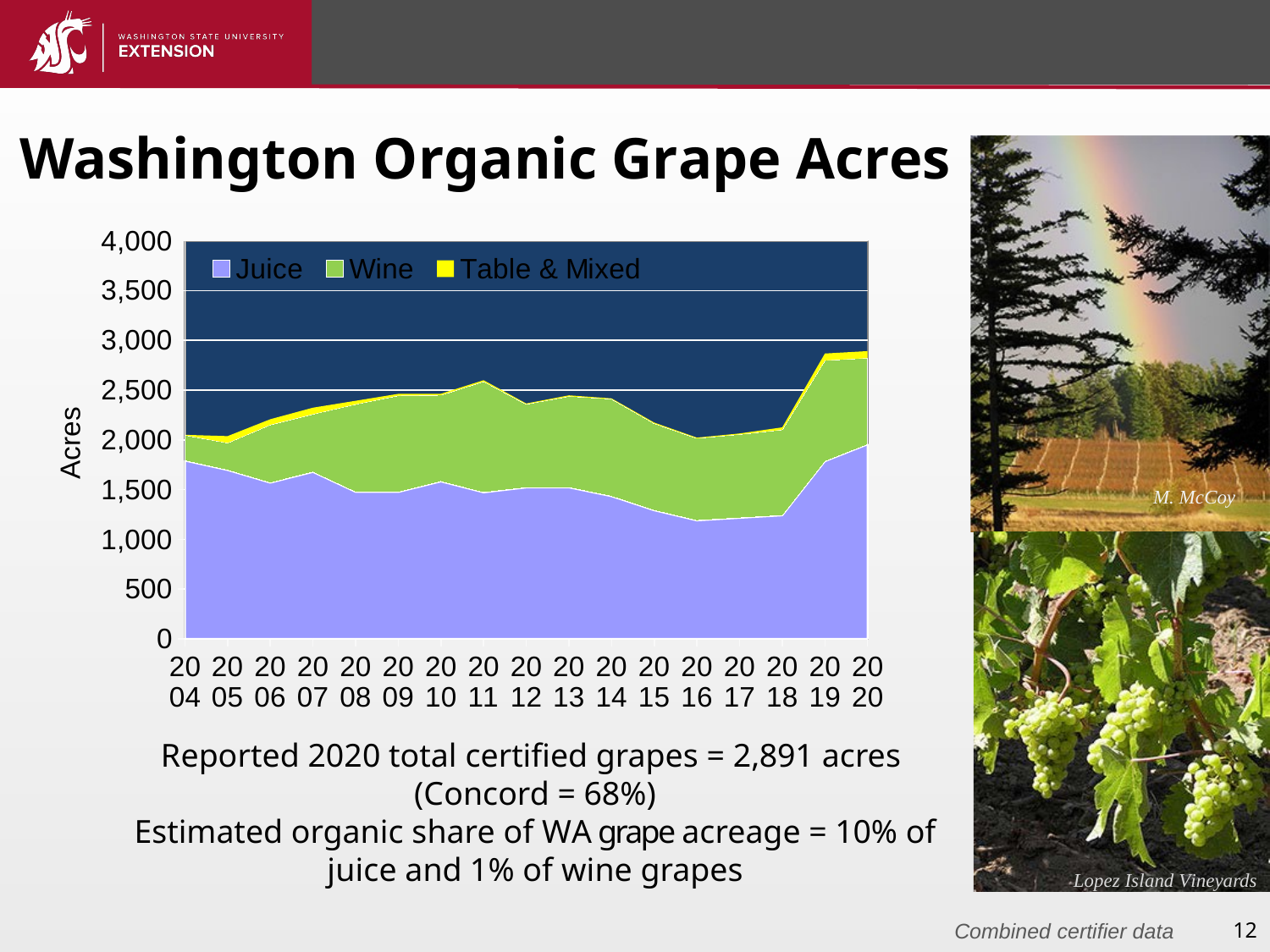
What kind of chart is shown on the slide? Stacked area chart Does the Juice series rise or fall from 2004 to 2016? Fall Is the Juice value for 2016 greater or less than 1,500 acres? less Is the total stacked value for 2004 greater or less than 2,500 acres? less What is the title of the chart on the slide? Washington Organic Grape Acres What is the label on the vertical axis of the chart? Acres Is the Juice value for 2004 greater or less than 1,500 acres? greater According to the slide, what was the reported 2020 total of certified grape acres? 2,891 acres How many years are plotted along the x axis of the chart? 17 Which series contributes the smallest area in the chart? Table & Mixed How many series does the chart legend list? 3